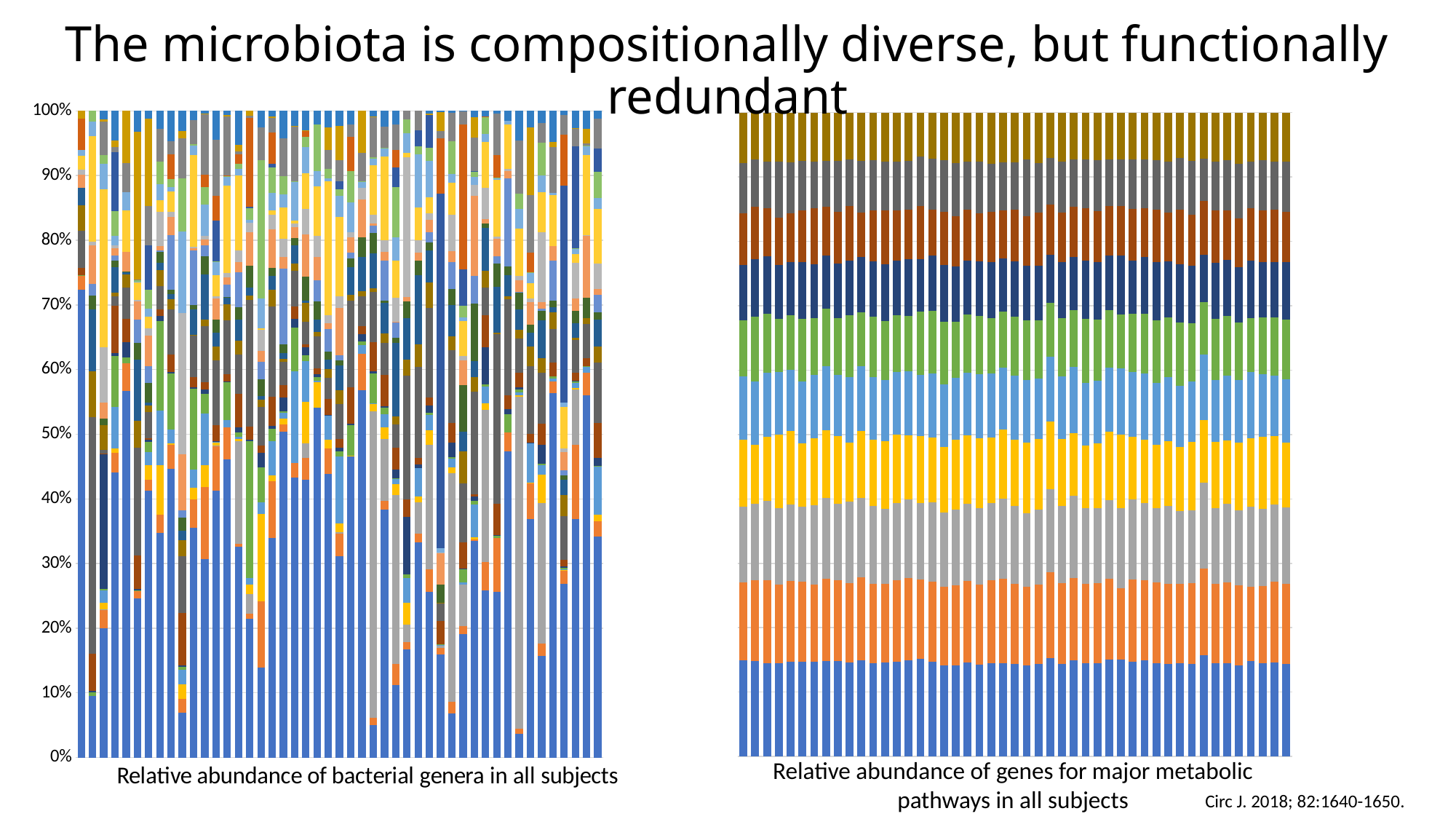
What kind of chart is the right chart, 'Relative abundance of genes for major metabolic pathways in all subjects'? Stacked bar chart In the left chart, is the blue bottom segment of the third bar from the left greater or less than 30%? less In the right chart, is the blue bottom segment of the first (leftmost) bar greater or less than 20%? less What kind of chart is the left chart, 'Relative abundance of bacterial genera in all subjects'? Stacked bar chart In the left chart, what is the total of each stacked bar? 100% In the left chart, which has the larger blue bottom segment: the first (leftmost) bar or the last (rightmost) bar? The first (leftmost) bar What is the caption of the right chart? Relative abundance of genes for major metabolic pathways in all subjects In the left chart, is the blue bottom segment of the last (rightmost) bar greater or less than 40%? less What is the caption of the left chart? Relative abundance of bacterial genera in all subjects